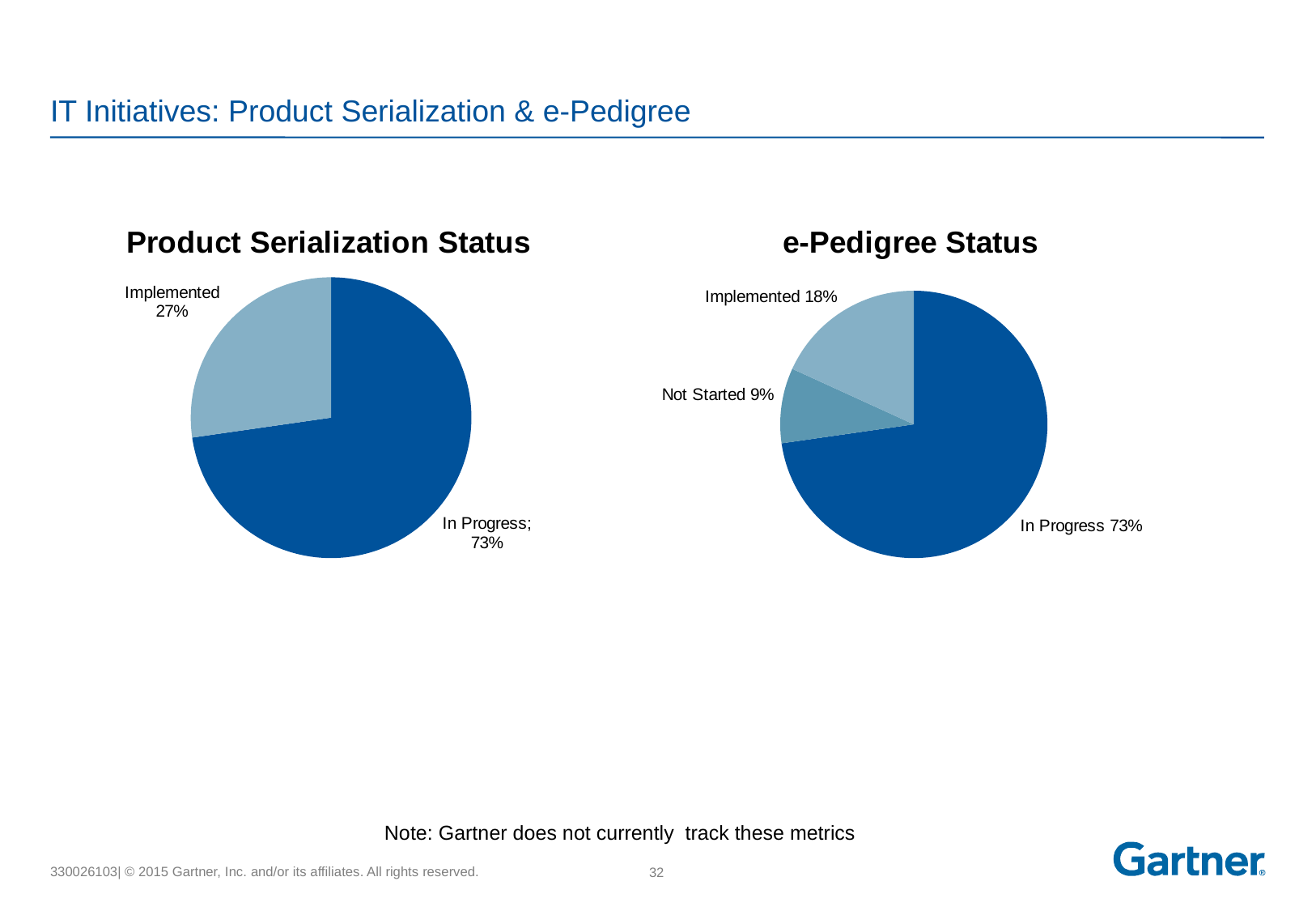
In the Product Serialization Status chart, what is the difference between the In Progress and Implemented shares? 46% In the e-Pedigree Status chart, which category has the largest slice? In Progress In the Product Serialization Status chart, what share is Implemented? 27% In the e-Pedigree Status chart, which category has the smallest slice? Not Started What type of chart is the Product Serialization Status chart? Pie chart In the e-Pedigree Status chart, what share is Implemented? 18% Which chart shows a larger Implemented share, Product Serialization Status or e-Pedigree Status? Product Serialization Status In the Product Serialization Status chart, which category has the smaller slice? Implemented In the e-Pedigree Status chart, what share is Not Started? 9% In the Product Serialization Status chart, what share is In Progress? 73% In the e-Pedigree Status chart, what is the difference between the Implemented and Not Started shares? 9% How many slices does the e-Pedigree Status chart have? 3